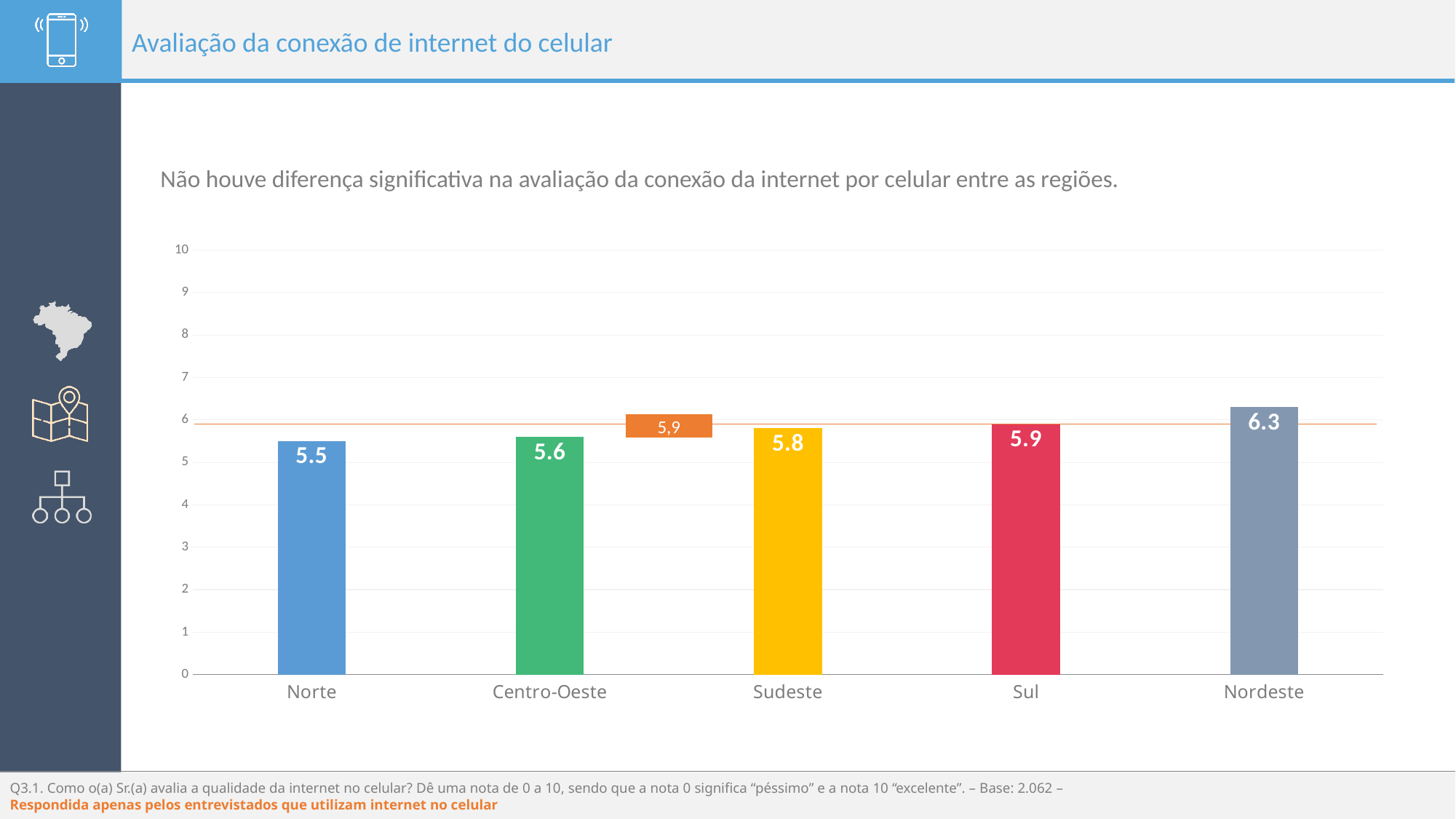
Is the value for Nordeste greater or less than 6? greater What value is labelled on the orange horizontal line across the chart? 5,9 What is the value for Norte? 5.5 What is the title of the slide? Avaliação da conexão de internet do celular Which is larger, the value for Sul or the value for Centro-Oeste? Sul Which region has the highest value? Nordeste Which region has the lowest value? Norte What is the value for Sudeste? 5.8 How many regions are shown on the x axis? 5 What kind of chart is shown on the slide? bar chart What is the difference between the values for Nordeste and Norte? 0.8 What is the value for Nordeste? 6.3